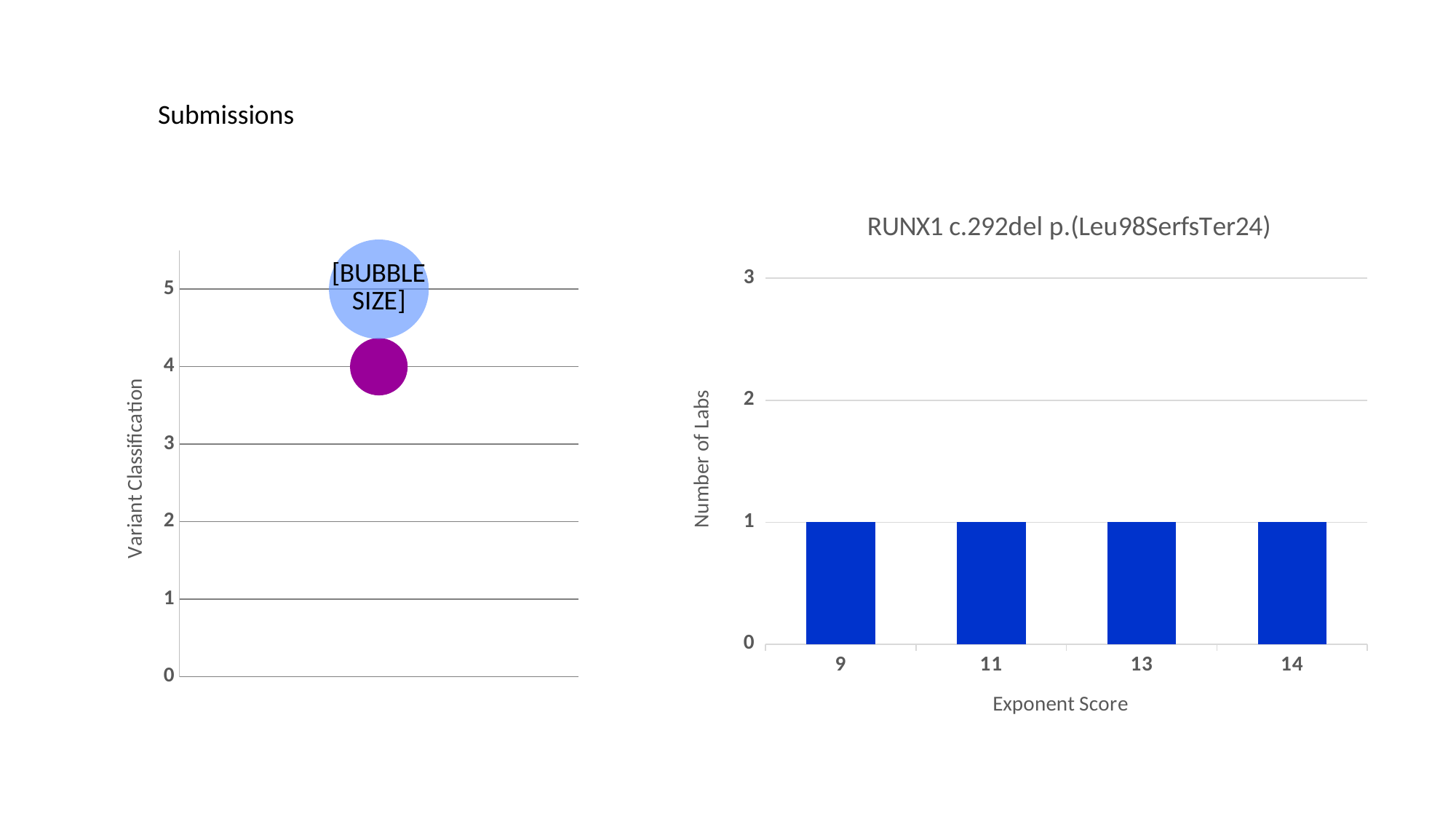
In the RUNX1 c.292del p.(Leu98SerfsTer24) chart, what is the difference in number of labs between exponent score 13 and exponent score 9? 0 In the Submissions chart on the left, which bubble is positioned higher on the Variant Classification axis, the light blue one or the purple one? the light blue one What kind of chart is the RUNX1 c.292del p.(Leu98SerfsTer24) chart? bar chart In the Submissions chart on the left, is the purple bubble's variant classification value greater or less than 3? greater What is the y-axis label of the Submissions chart on the left? Variant Classification In the RUNX1 c.292del p.(Leu98SerfsTer24) chart, do the bar values rise, fall, or stay the same across the exponent scores? stay the same In the RUNX1 c.292del p.(Leu98SerfsTer24) chart, what is the number of labs for exponent score 14? 1 In the Submissions chart on the left, how many bubbles are plotted? 2 What is the x-axis label of the RUNX1 c.292del p.(Leu98SerfsTer24) chart? Exponent Score In the RUNX1 c.292del p.(Leu98SerfsTer24) chart, what is the number of labs for exponent score 9? 1 In the RUNX1 c.292del p.(Leu98SerfsTer24) chart, is the number of labs for exponent score 11 greater or less than 2? less In the RUNX1 c.292del p.(Leu98SerfsTer24) chart, how many exponent score categories are shown on the x axis? 4